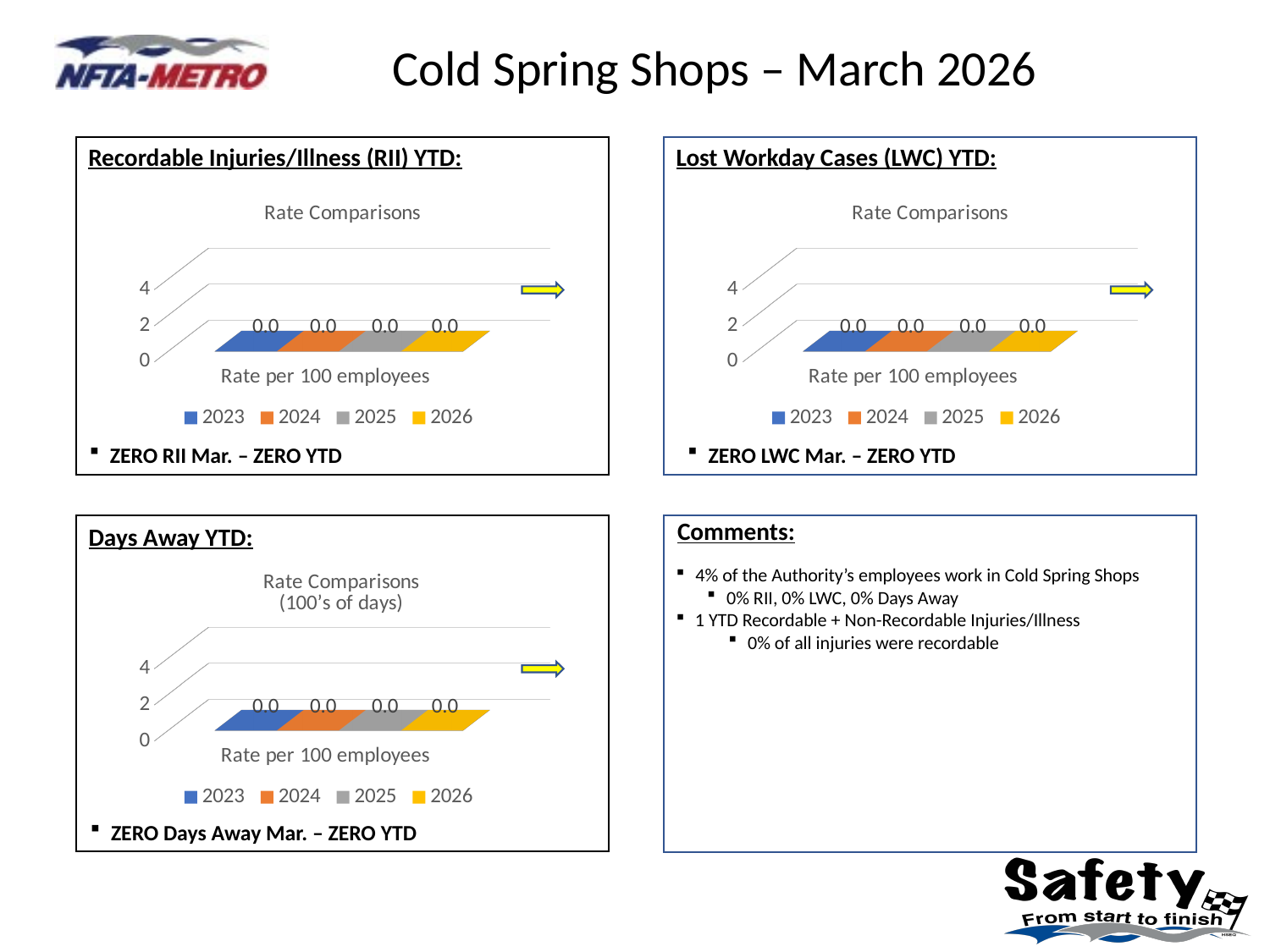
How many categories are shown on the x axis of the Recordable Injuries/Illness (RII) YTD chart? 1 What is the title of the chart in the Days Away YTD box? Rate Comparisons (100's of days) In the Lost Workday Cases (LWC) YTD chart, what is the difference between the 2025 and 2026 values? 0.0 In the Days Away YTD chart, is the value for 2026 greater or less than 2? less In the Days Away YTD chart, what is the value for 2025? 0.0 What kind of chart is shown in the Recordable Injuries/Illness (RII) YTD box? Bar chart In the Recordable Injuries/Illness (RII) YTD chart, what is the value for 2026? 0.0 In the Lost Workday Cases (LWC) YTD chart, what is the value for 2023? 0.0 In the Recordable Injuries/Illness (RII) YTD chart, what is the value for 2024? 0.0 How many series does the legend list in the Lost Workday Cases (LWC) YTD chart? 4 What is the x-axis category label in the Lost Workday Cases (LWC) YTD chart? Rate per 100 employees How many series does the legend list in the Days Away YTD chart? 4